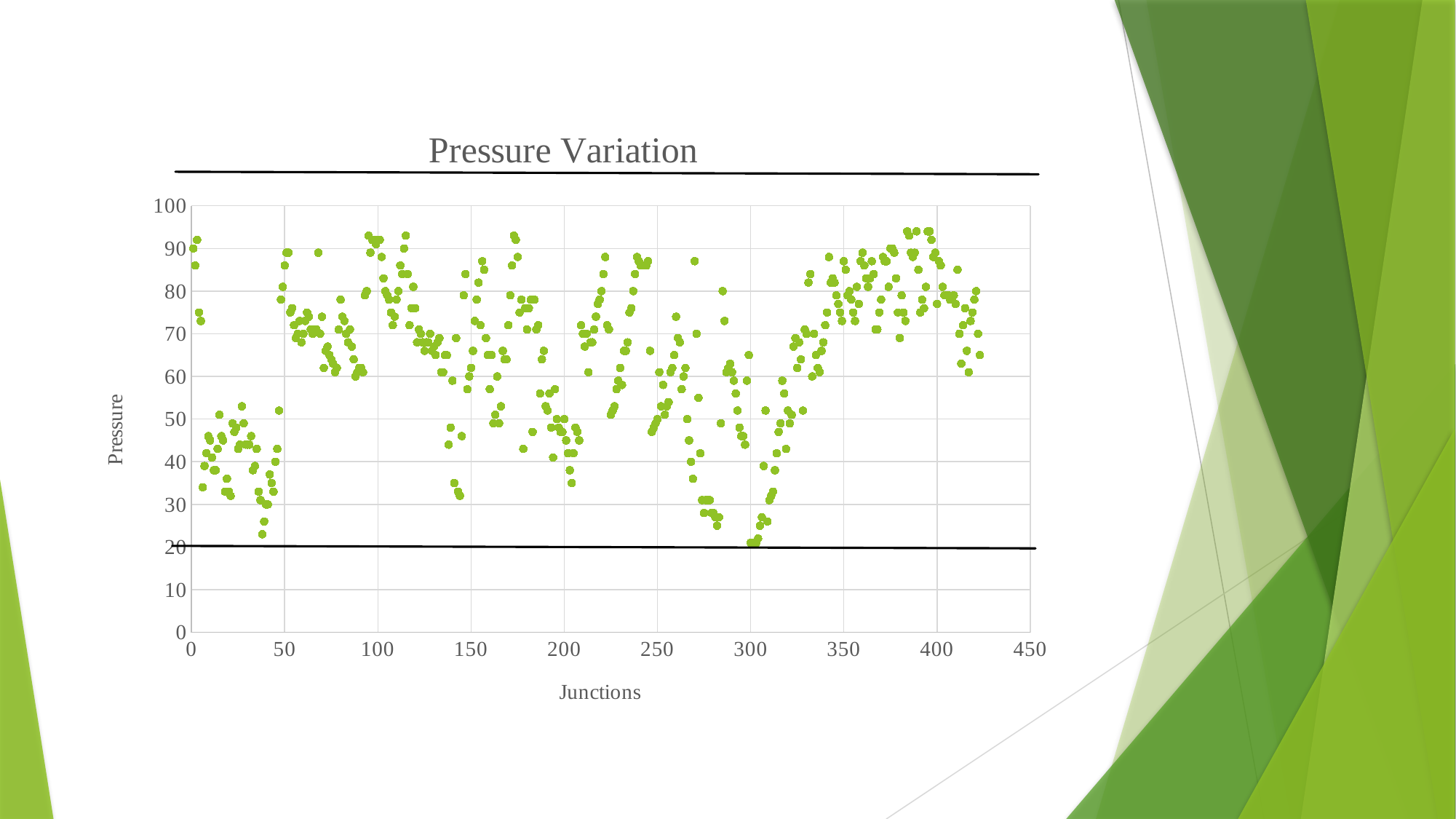
What kind of chart is shown on the slide? scatter chart Is the highest pressure value plotted near junction 390 greater or less than 90? greater Is the lowest pressure value plotted near junction 300 greater or less than 30? less What is the title of the chart? Pressure Variation Is the highest pressure value plotted near junction 100 greater or less than 90? greater What is the label on the horizontal axis of the chart? Junctions